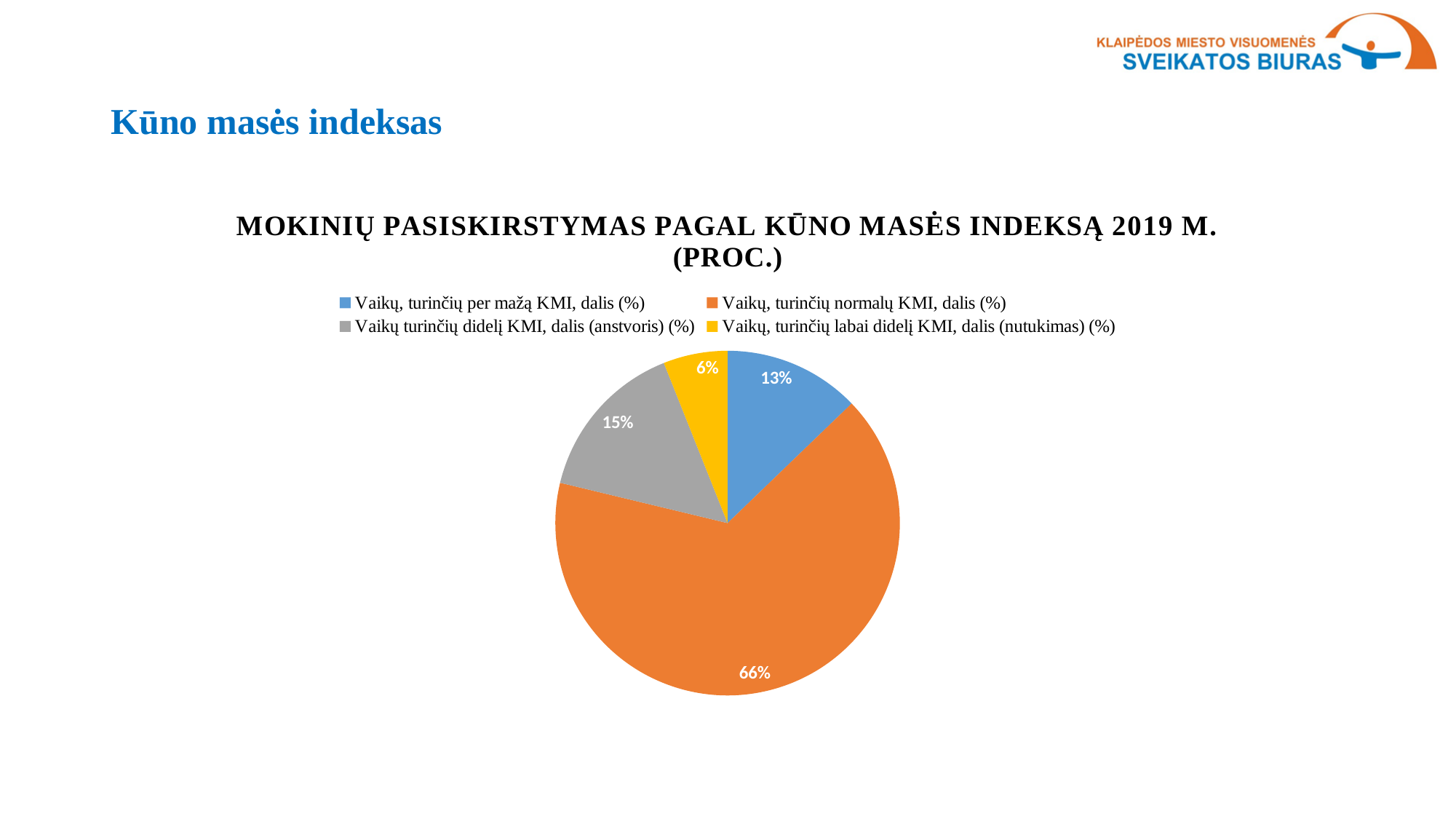
Which category has the smallest slice of the pie? Vaikų, turinčių labai didelį KMI, dalis (nutukimas) (%) How many entries does the legend list? 4 What share of the pie is labelled for 'Vaikų, turinčių labai didelį KMI, dalis (nutukimas) (%)'? 6% What is the difference in percentage points between the slice for normal KMI (66%) and the slice for too-low KMI (13%)? 53 What share of the pie is labelled for 'Vaikų turinčių didelį KMI, dalis (anstvoris) (%)'? 15% What share of the pie is labelled for 'Vaikų, turinčių per mažą KMI, dalis (%)'? 13% How many slices does the pie chart have? 4 Which category has the largest slice of the pie? Vaikų, turinčių normalų KMI, dalis (%) What kind of chart is shown on the slide? pie chart What share of the pie is labelled for 'Vaikų, turinčių normalų KMI, dalis (%)'? 66% What colour is the slice for 'Vaikų, turinčių normalų KMI, dalis (%)'? orange Which slice is larger: 'Vaikų turinčių didelį KMI, dalis (anstvoris) (%)' or 'Vaikų, turinčių per mažą KMI, dalis (%)'? Vaikų turinčių didelį KMI, dalis (anstvoris) (%)